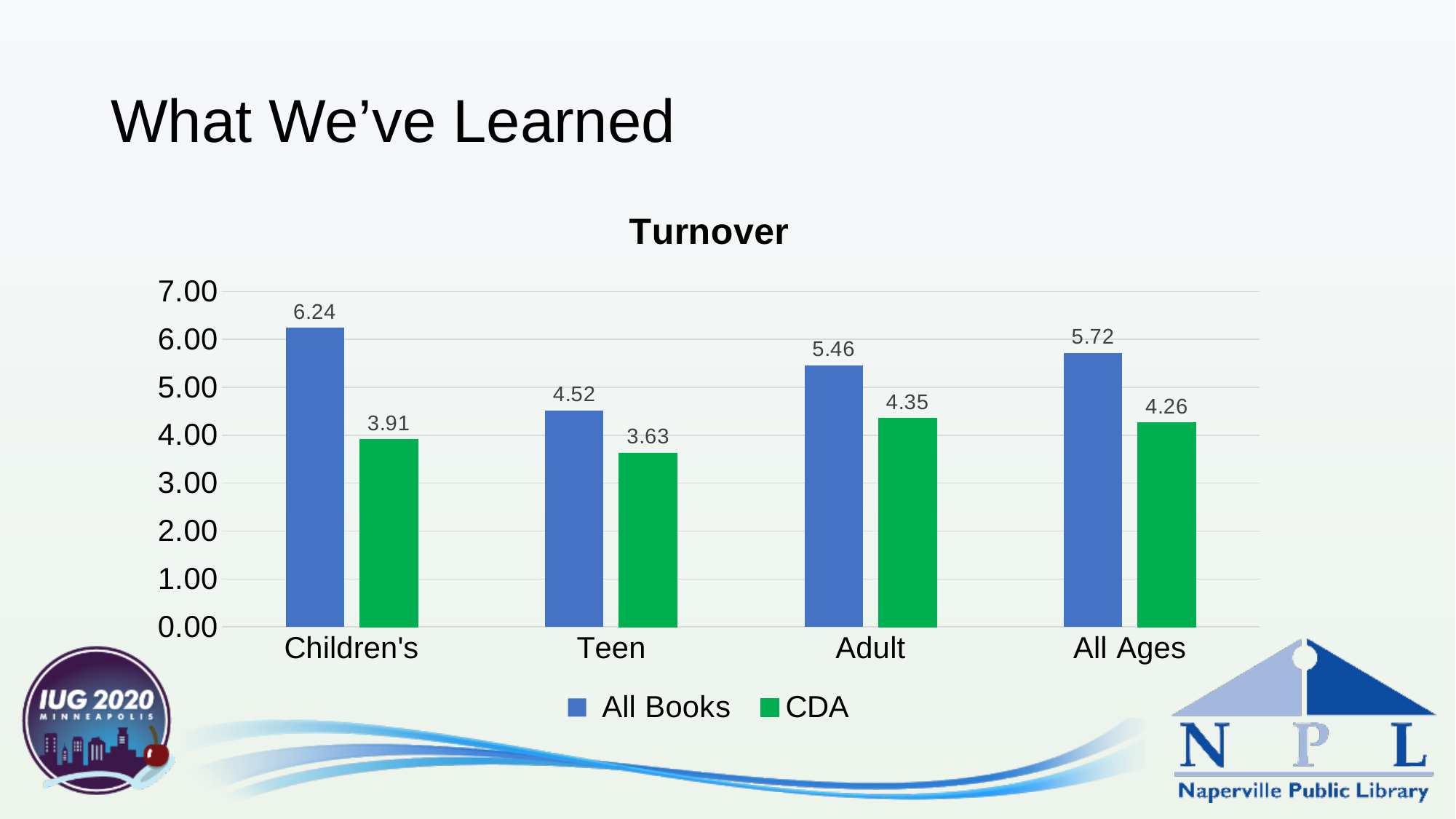
What is the Turnover value for CDA in the Teen category? 3.63 Is the CDA turnover for All Ages greater or less than 5.00? less What type of chart is used to show Turnover? Bar chart What is the Turnover value for All Books in the All Ages category? 5.72 How many series does the legend of the Turnover chart list? 2 What is the Turnover value for All Books in the Children's category? 6.24 Which is larger in the Adult category, the All Books turnover or the CDA turnover? All Books What is the difference between the All Books and CDA turnover values for Children's? 2.33 Which category has the lowest CDA turnover? Teen What is the Turnover value for CDA in the Adult category? 4.35 How many categories are shown on the x axis of the Turnover chart? 4 Which category has the highest All Books turnover? Children's